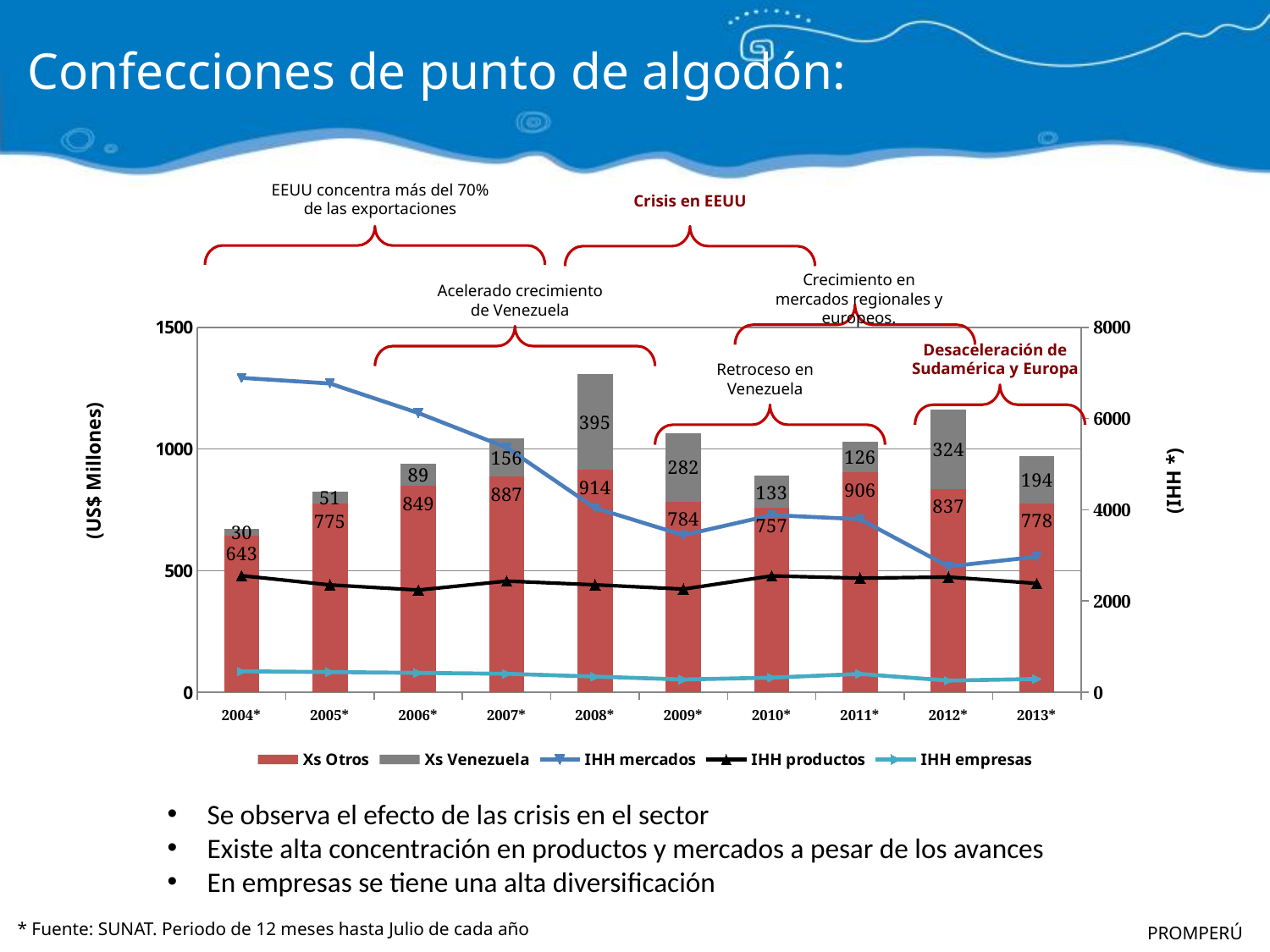
Which year has the lowest Xs Otros value? 2004* What is the value of Xs Otros for 2008*? 914 What is the total of the stacked bar for 2008* (Xs Otros plus Xs Venezuela)? 1309 Which year has the highest Xs Venezuela value? 2008* Does the IHH mercados line generally rise or fall from 2004* to 2012*? fall What is the value of Xs Venezuela for 2012*? 324 Which is larger, the Xs Venezuela value for 2009* or for 2013*? 2009* How many series does the legend list? 5 What is the difference between the Xs Otros values for 2011* and 2010*? 149 How many years are shown on the x axis? 10 Is the IHH empresas value for 2013* greater or less than 2000 on the right axis? less Is the IHH mercados value for 2004* greater or less than 6000 on the right axis? greater